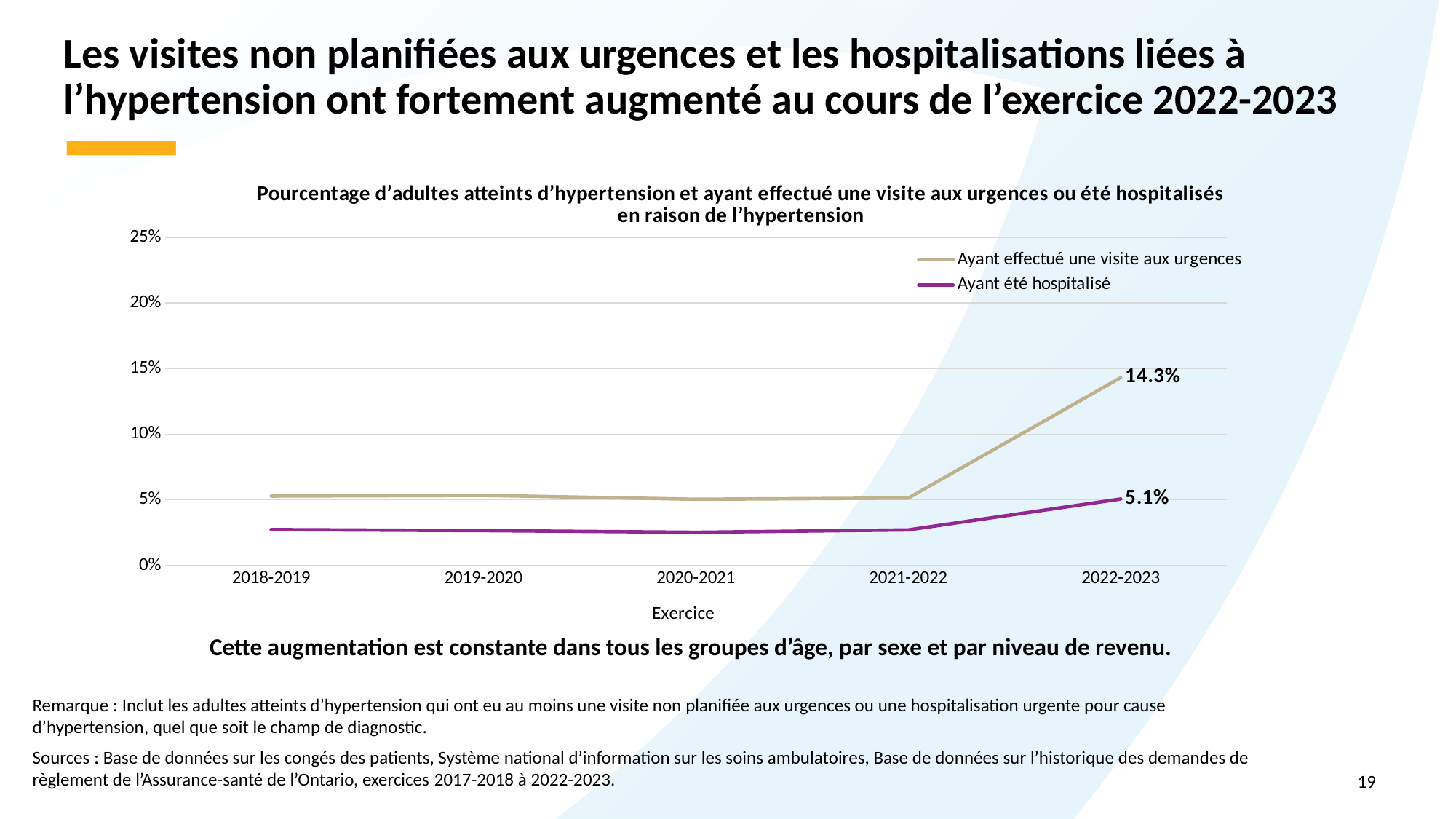
Does the value for "Ayant effectué une visite aux urgences" rise or fall between 2021-2022 and 2022-2023? Rise In 2022-2023, which series has the larger value: "Ayant effectué une visite aux urgences" or "Ayant été hospitalisé"? Ayant effectué une visite aux urgences Is the value for "Ayant été hospitalisé" in 2021-2022 greater or less than 5%? less What is the title of the x axis of the chart? Exercice What is the value for "Ayant effectué une visite aux urgences" in 2022-2023? 14.3% What is the value for "Ayant été hospitalisé" in 2022-2023? 5.1% What is the difference between the 2022-2023 values for emergency visits (14.3%) and hospitalisations (5.1%)? 9.2 percentage points How many fiscal years (exercices) are shown on the x axis of the chart? 5 How many series does the chart legend list? 2 What type of chart is shown on the slide? Line chart Is the value for "Ayant effectué une visite aux urgences" in 2018-2019 greater or less than 10%? less In which fiscal year is the value for "Ayant effectué une visite aux urgences" highest? 2022-2023